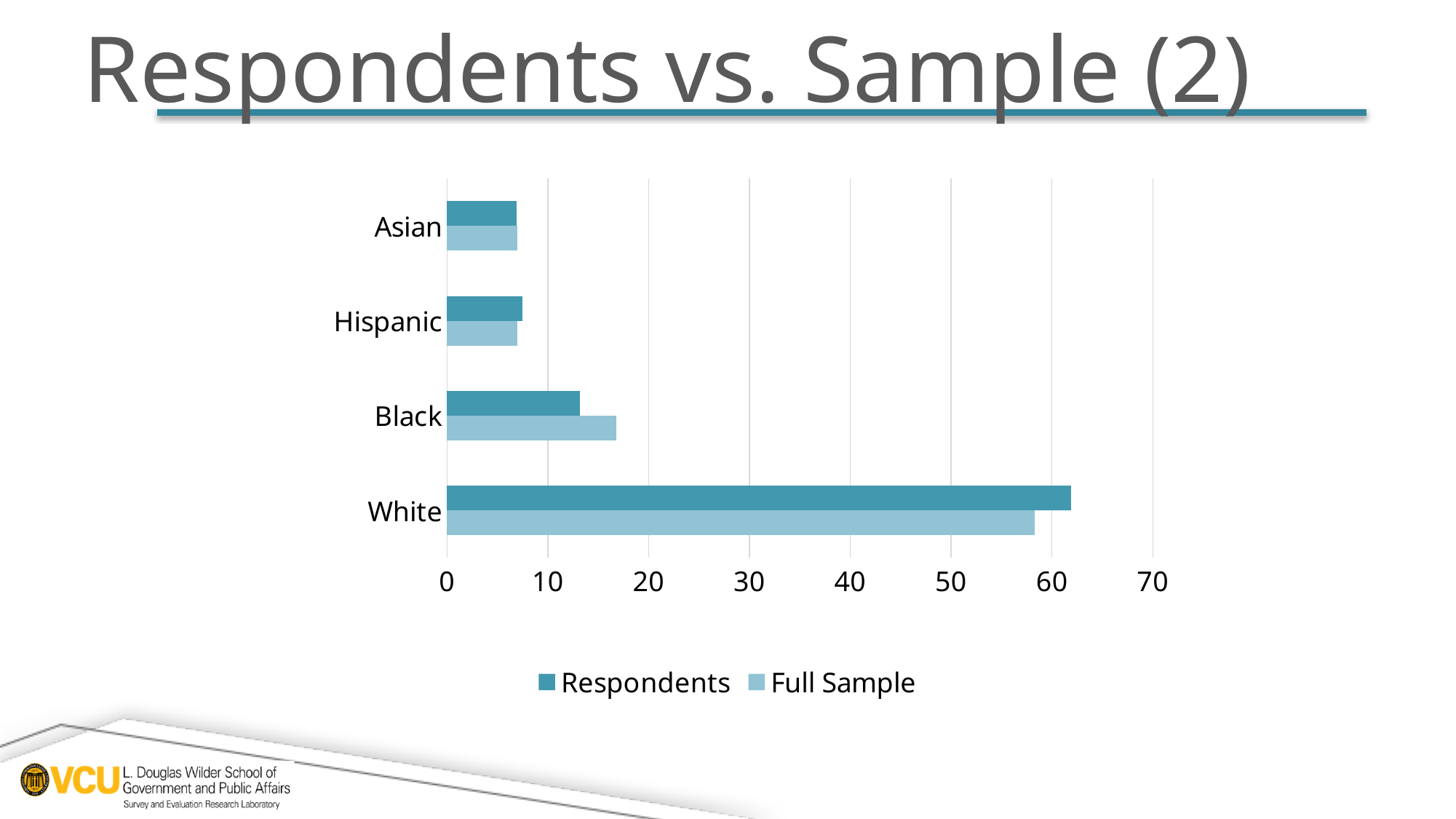
Is the Full Sample value for White greater or less than 60? less How many categories are shown on the chart? 4 How many series does the legend list? 2 Which category has the highest Full Sample value? White What kind of chart is shown on the slide? bar chart For White, which series has the larger value, Respondents or Full Sample? Respondents What are the two series named in the legend? Respondents and Full Sample Is the Respondents value for Asian greater or less than 10? less Which category has the highest Respondents value? White Is the Full Sample value for Black greater or less than 10? greater For Black, which series has the larger value, Respondents or Full Sample? Full Sample